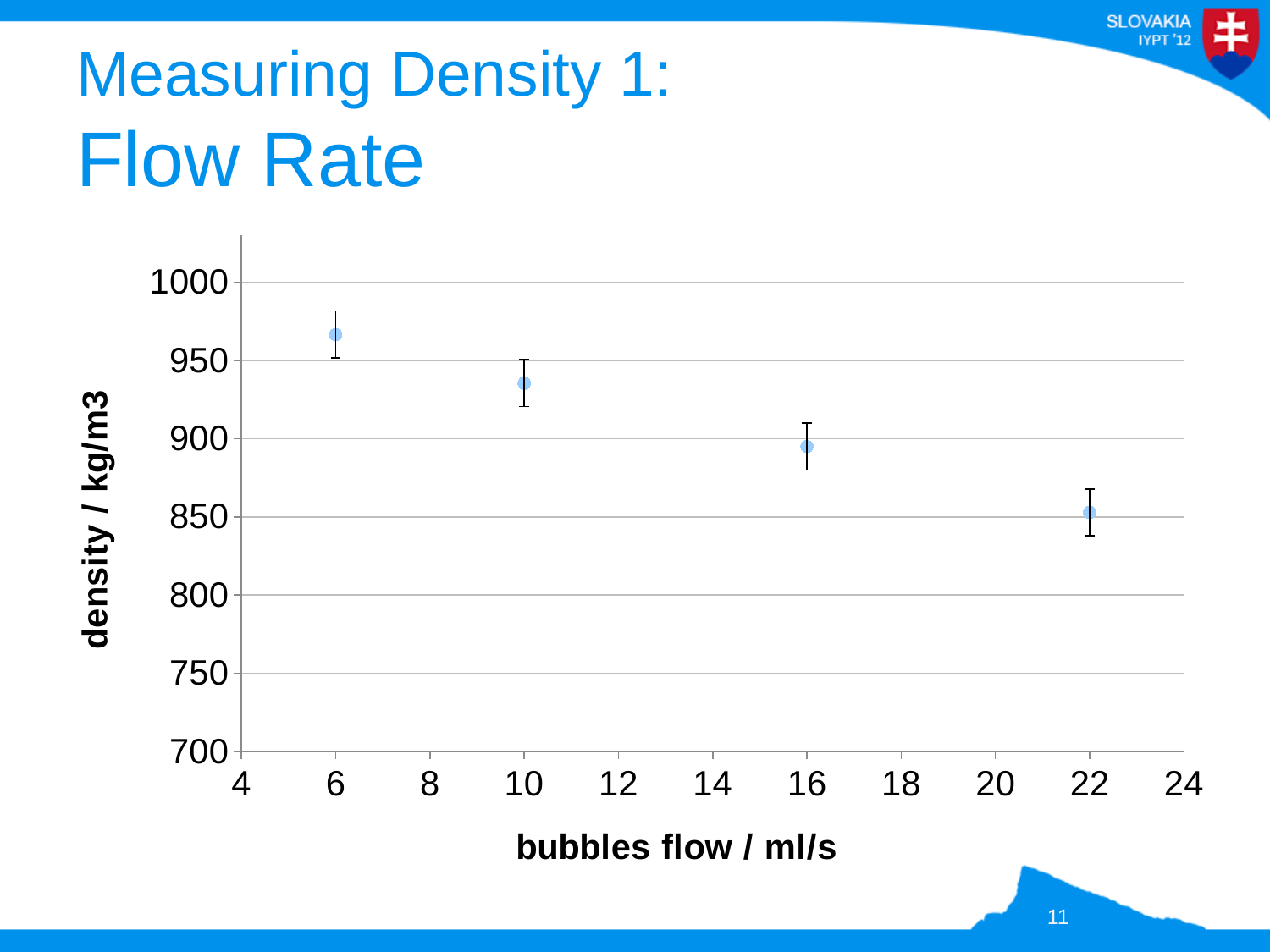
How many data points are plotted on the chart? 4 Is the density at a bubbles flow of 6 ml/s greater or less than 950? greater At which bubbles flow value is the density highest? 6 Is the density at a bubbles flow of 10 ml/s greater or less than 950? less What is the label of the y axis? density / kg/m3 What is the label of the x axis? bubbles flow / ml/s Do the density values rise or fall as bubbles flow increases along the x axis? fall What kind of chart is shown on the slide? scatter plot Is the density at a bubbles flow of 22 ml/s greater or less than 900? less Which has the larger density: the point at a bubbles flow of 10 ml/s or the point at 16 ml/s? 10 ml/s At which bubbles flow value is the density lowest? 22